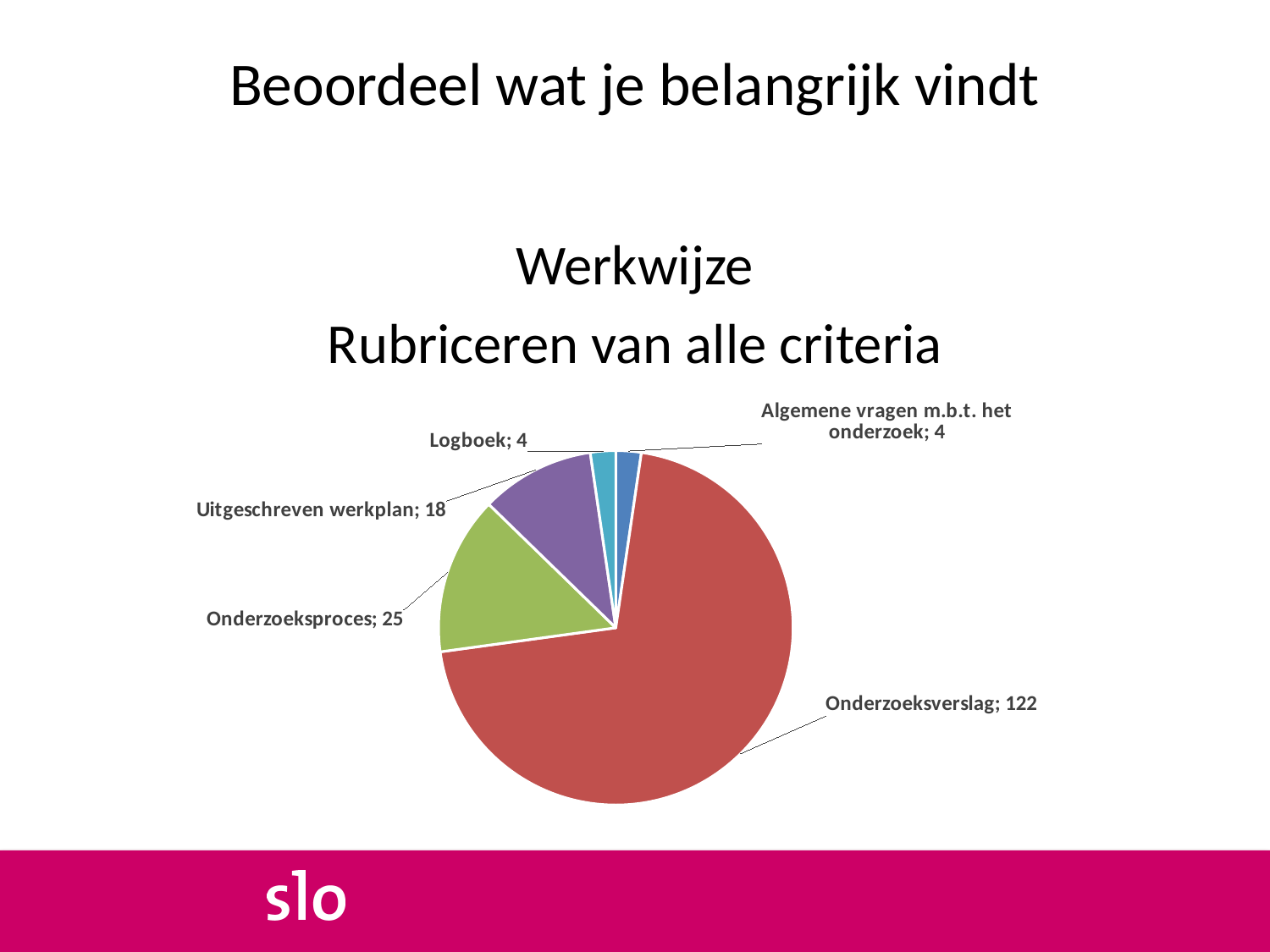
What is the value for Onderzoeksproces? 25 What kind of chart is shown on the slide? pie chart What is the difference between the values for Onderzoeksverslag and Onderzoeksproces? 97 How many slices does the pie chart have? 5 What is the value for Uitgeschreven werkplan? 18 Which category has the largest slice of the pie? Onderzoeksverslag Which is larger, the value for Onderzoeksproces or the value for Uitgeschreven werkplan? Onderzoeksproces What colour is the slice for Onderzoeksverslag? red What is the value for Onderzoeksverslag? 122 Which two categories share the smallest value in the pie chart? Logboek and Algemene vragen m.b.t. het onderzoek What is the difference between the values for Uitgeschreven werkplan and Logboek? 14 What is the value for Logboek? 4